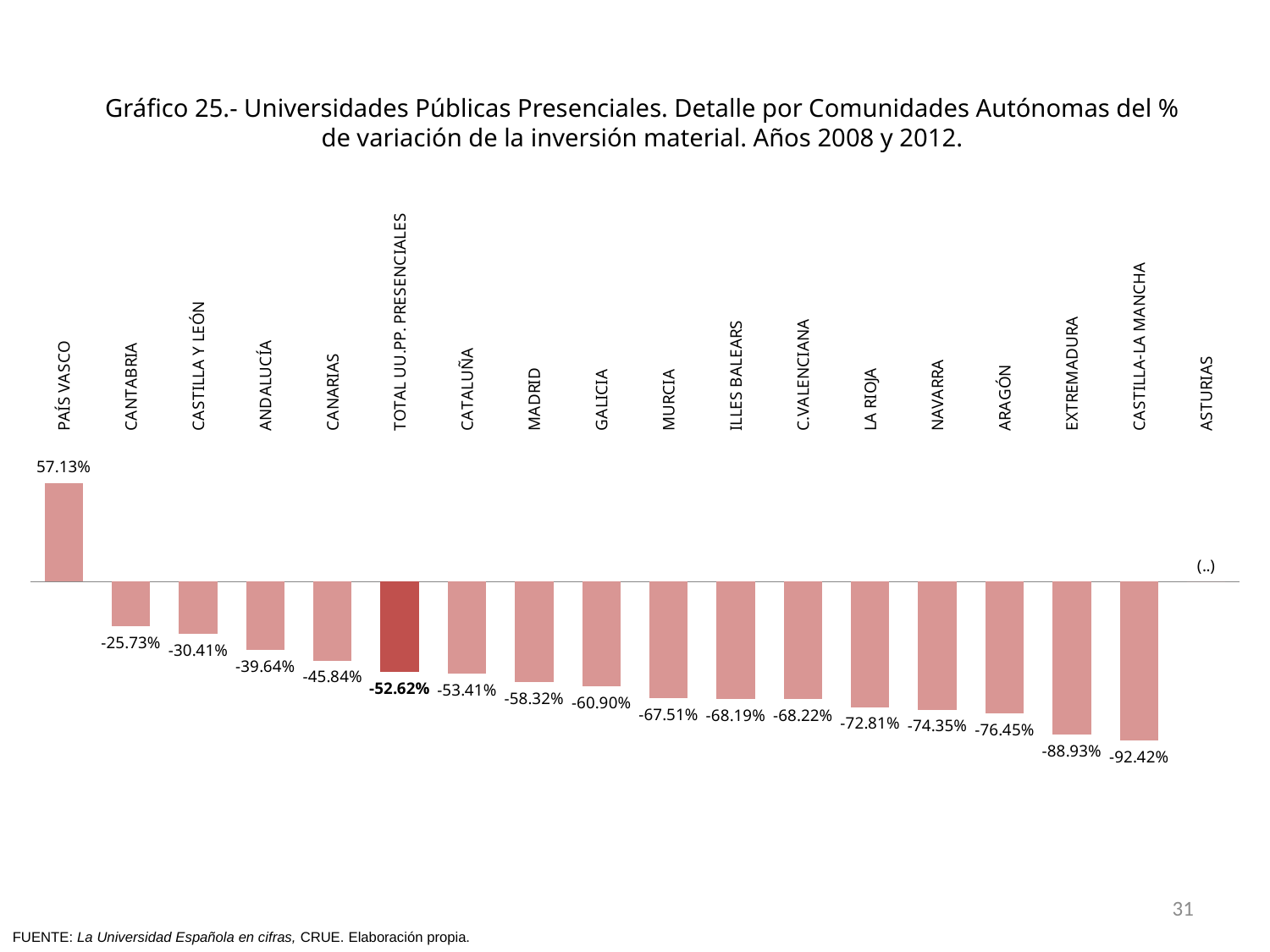
What type of chart is shown on the slide? Bar chart What is the value shown for EXTREMADURA? -88.93% Which category has the lowest value? CASTILLA-LA MANCHA What is the value shown for TOTAL UU.PP. PRESENCIALES? -52.62% Which has the larger value, MURCIA or GALICIA? GALICIA What is the value shown for GALICIA? -60.90% Which category has the highest value? PAÍS VASCO What is the difference between the values for CATALUÑA and MADRID? 4.91 percentage points What is the difference between the values for EXTREMADURA and CASTILLA-LA MANCHA? 3.49 percentage points How many categories have a bar plotted on the chart? 17 What is the value shown for PAÍS VASCO? 57.13% Which category is shown with no bar and the marker (..) instead of a value? ASTURIAS